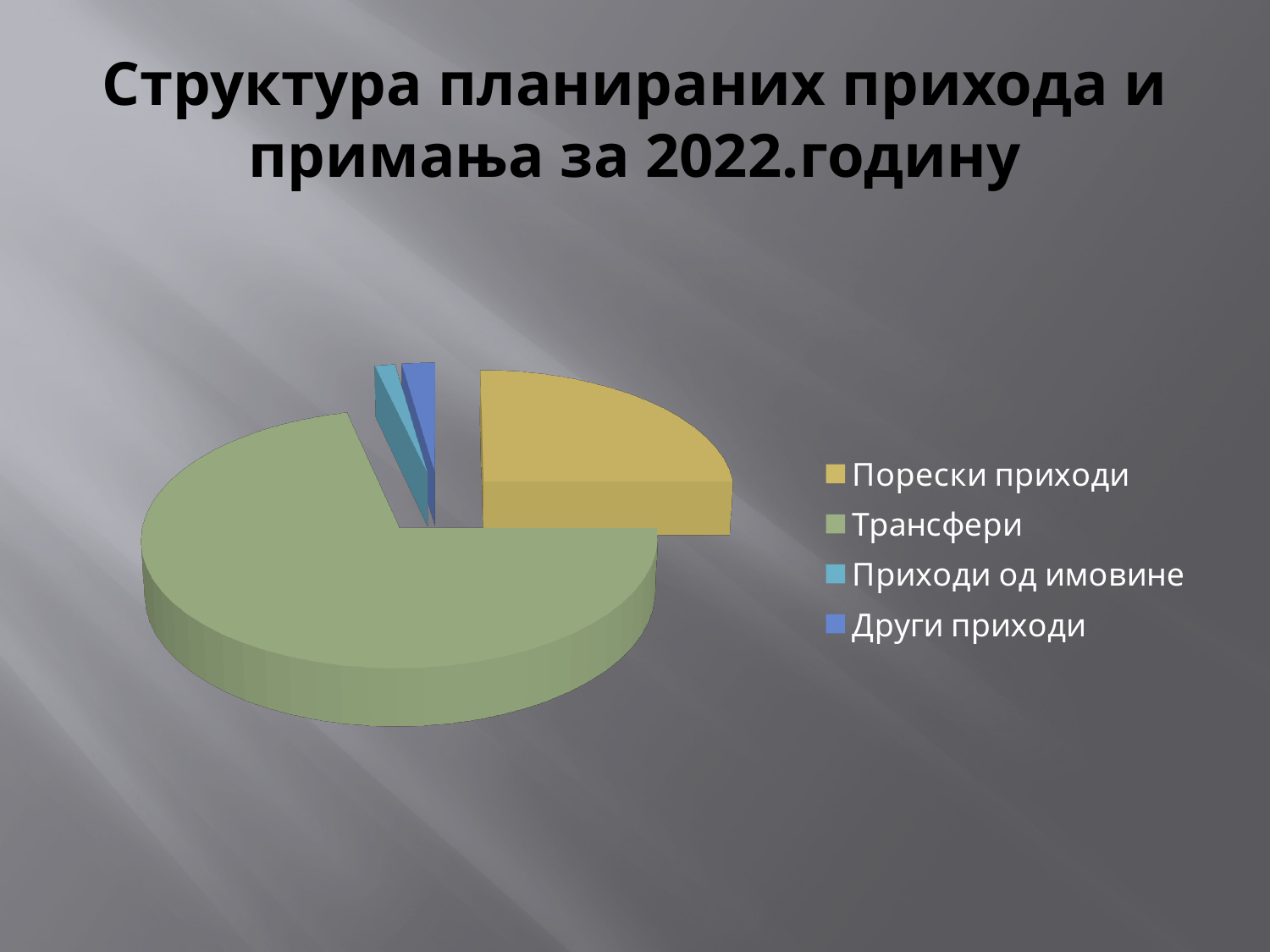
Which slice is larger, Трансфери or Порески приходи? Трансфери Which slice is larger, Порески приходи or Приходи од имовине? Порески приходи Which slice is larger, Трансфери or Приходи од имовине? Трансфери How many entries does the legend list? 4 What is the title of the slide? Структура планираних прихода и примања за 2022.годину Which category has the largest slice of the pie? Трансфери How many slices does the pie chart have? 4 What kind of chart is shown on the slide? pie chart What colour is the Трансфери slice in the pie chart? green